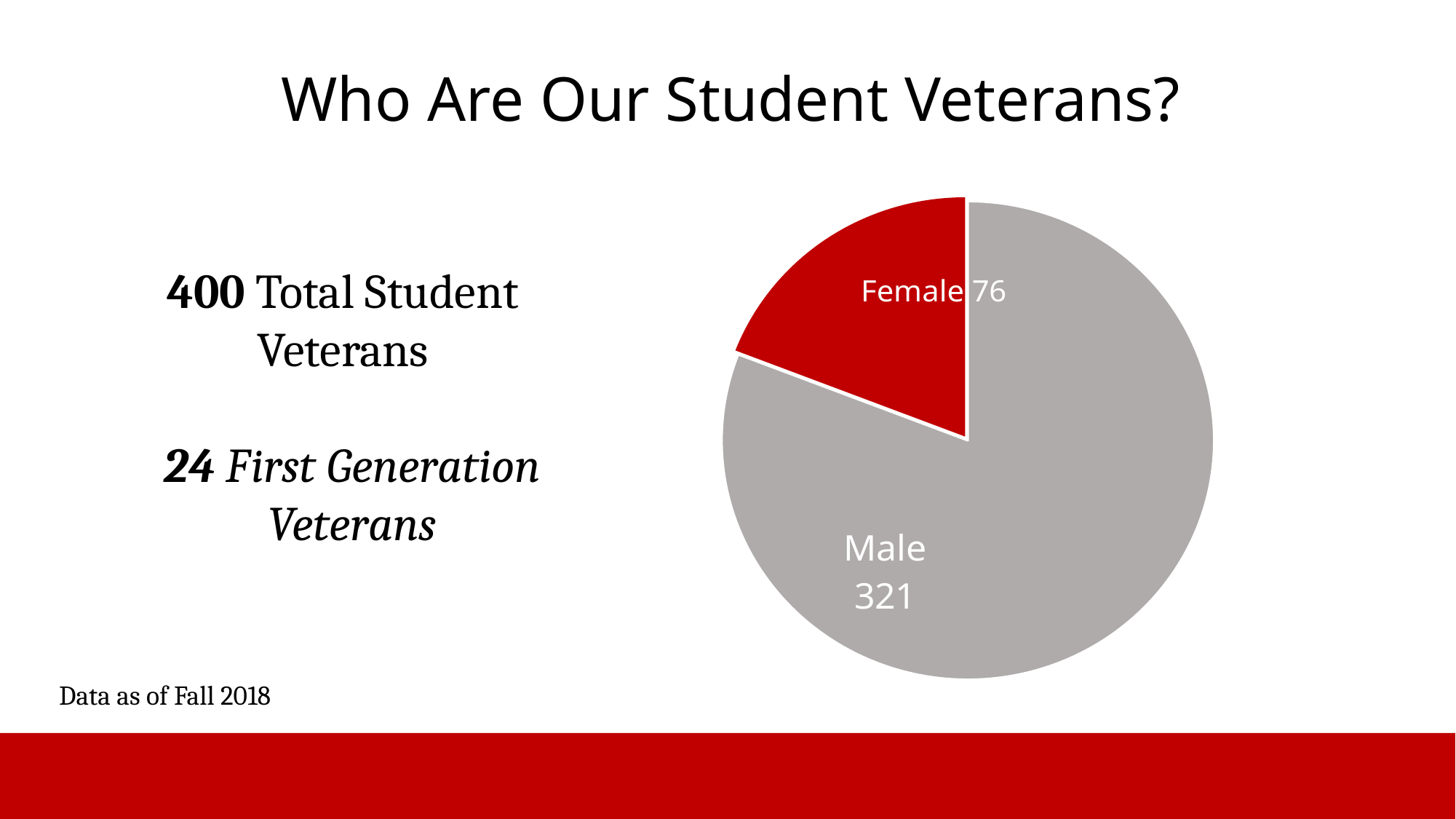
What share of the pie chart does the Female slice represent, to the nearest whole percent? 19% How many categories are shown in the pie chart? 2 Which category has the largest slice in the pie chart? Male What is the total of the two values shown in the pie chart? 397 What is the value for Male in the pie chart? 321 What kind of chart is shown on the slide? Pie chart What is the difference between the Male and Female values in the pie chart? 245 What colour is the Female slice in the pie chart? Red Which category has the smallest slice in the pie chart? Female What is the value for Female in the pie chart? 76 Which is larger in the pie chart, Male or Female? Male Which category is shown in grey in the pie chart? Male